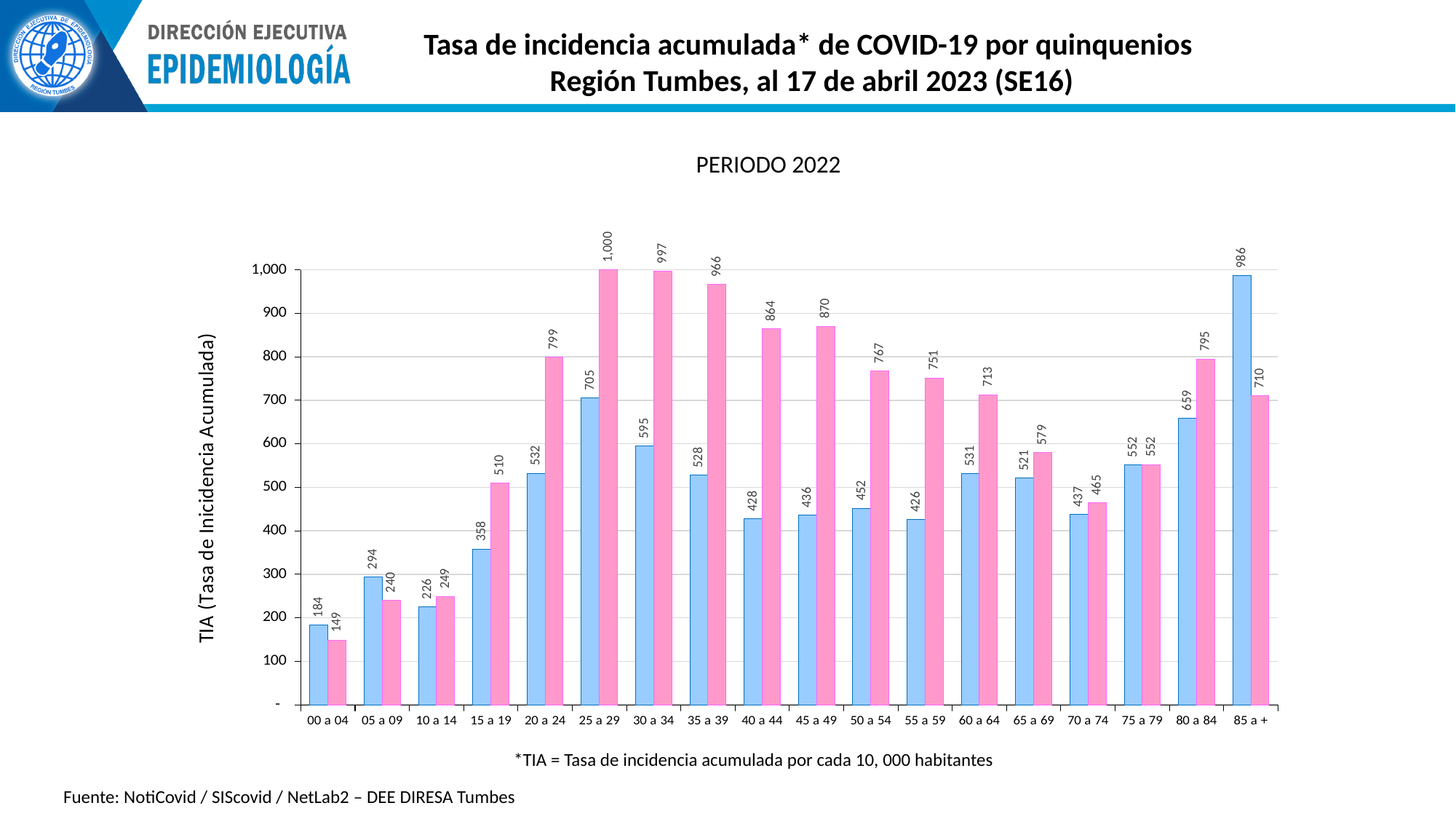
What is the difference between the pink bar and the blue bar for the 20 a 24 age group? 267 What kind of chart is shown on the slide? bar chart How many age groups are shown on the x axis? 18 Which age group has the highest blue bar? 85 a + What is the value of the pink bar for the 30 a 34 age group? 997 Which age group has the highest pink bar? 25 a 29 What is the value of the pink bar for the 00 a 04 age group? 149 Which age group has the lowest pink bar? 00 a 04 What is the title shown above the chart? PERIODO 2022 For the 85 a + age group, which is larger, the blue bar or the pink bar? the blue bar What is the label of the y axis? TIA (Tasa de Incidencia Acumulada) What is the value of the blue bar for the 25 a 29 age group? 705